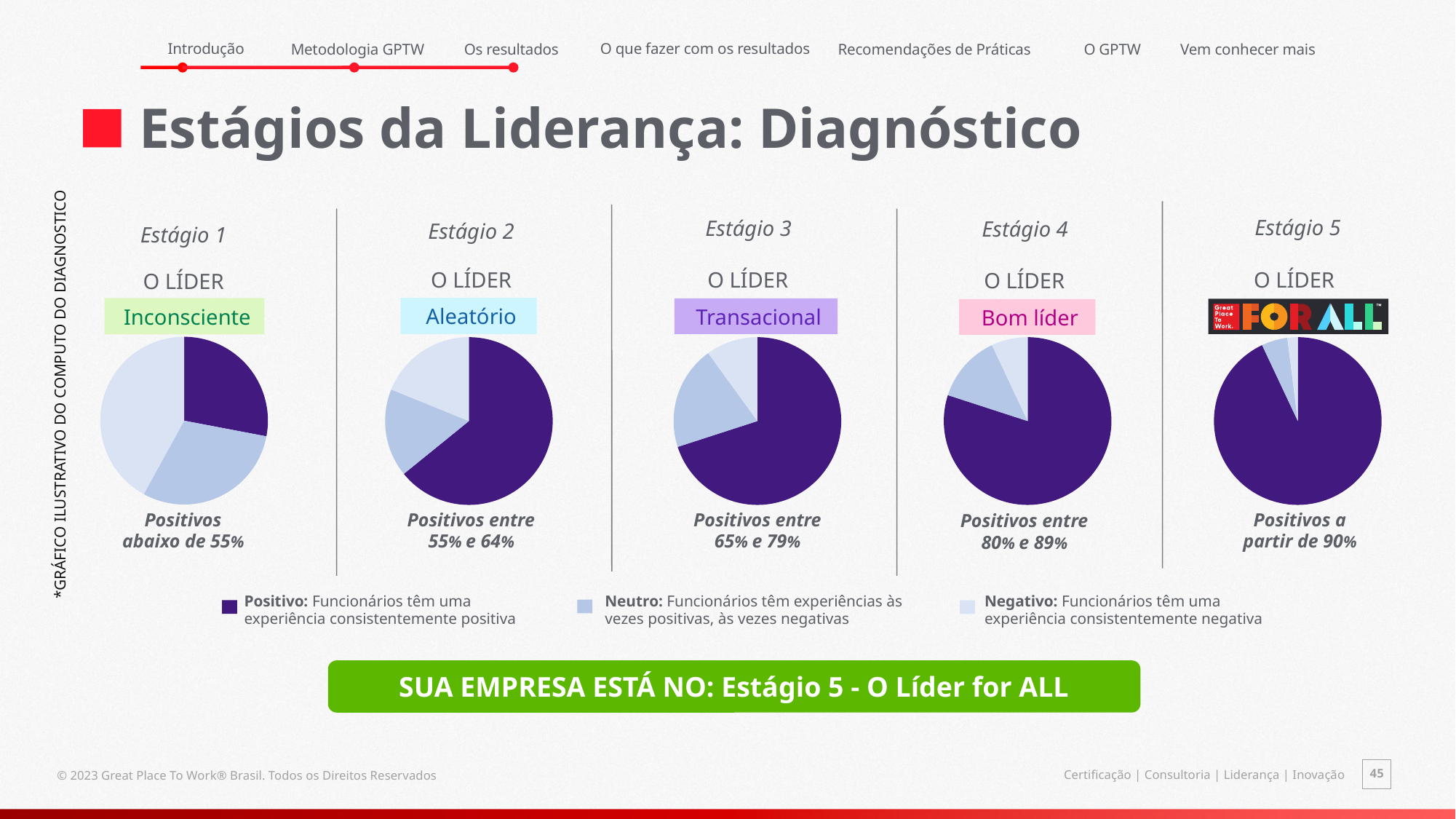
In the Estágio 1 (Inconsciente) pie chart, which slice is larger: Positivo or Negativo? Negativo In the Estágio 2 (Aleatório) pie chart, which category has the largest slice? Positivo How many slices does each pie chart on the slide have? 3 In the Estágio 4 (Bom líder) pie chart, which slice is larger: Neutro or Negativo? Neutro What kind of chart is used for each of the five Estágio diagrams on the slide? Pie chart What is the leader label shown above the Estágio 3 pie chart? Transacional What range of positive responses is written under the Estágio 4 pie chart? Positivos entre 80% e 89% In the Estágio 3 (Transacional) pie chart, which category has the largest slice? Positivo How many categories does the legend at the bottom of the slide list? 3 In the Estágio 4 (Bom líder) pie chart, which category has the largest slice? Positivo How many pie charts are shown on the slide? 5